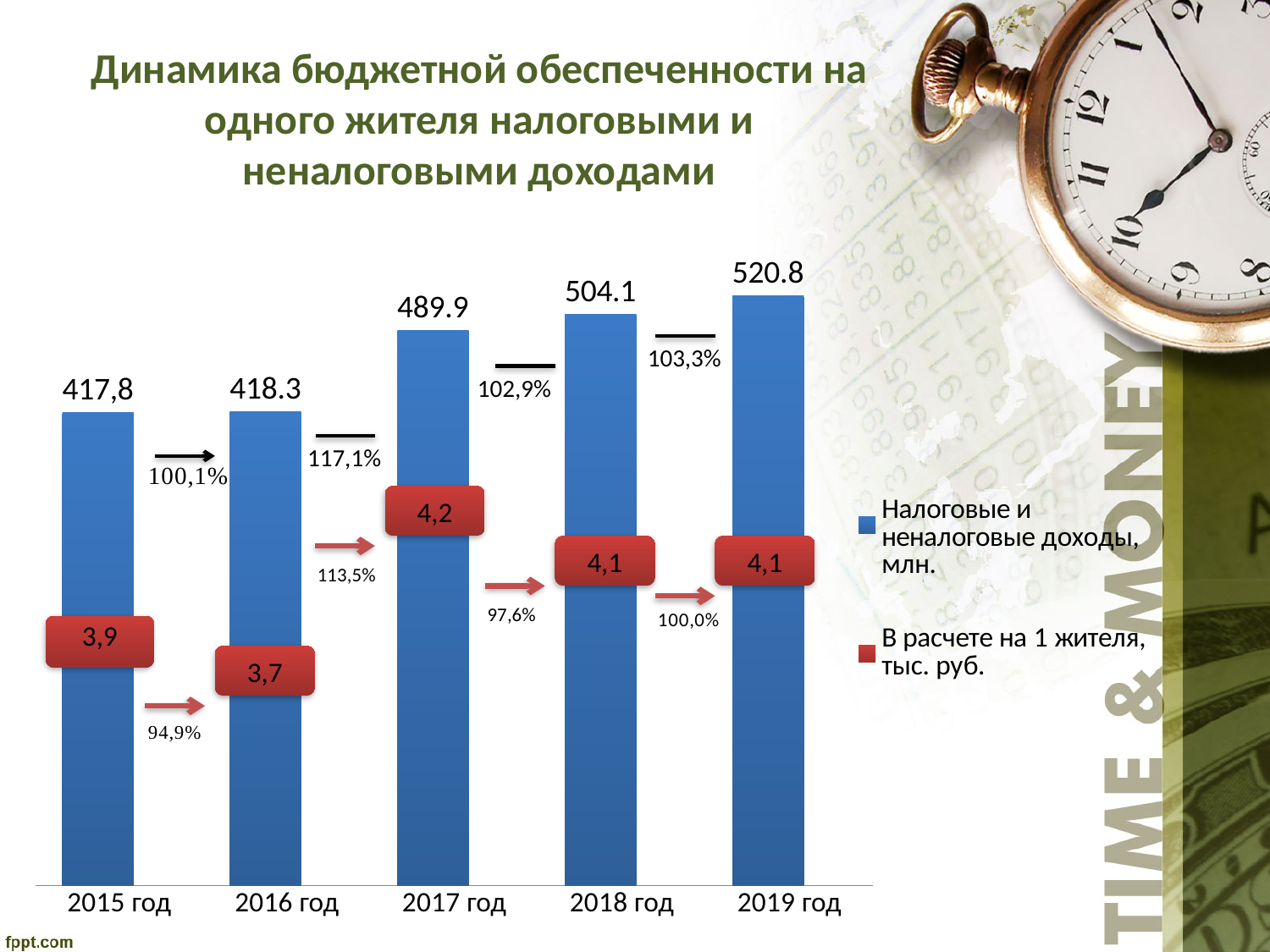
What is the difference between the tax and non-tax revenues (млн.) for 2019 год and 2018 год? 16.7 What is the per-resident value (тыс. руб.) for 2017 год? 4,2 Do the tax and non-tax revenues (млн.) rise or fall from 2015 год to 2019 год? Rise What is the value of tax and non-tax revenues (Налоговые и неналоговые доходы, млн.) for 2017 год? 489.9 What is the per-resident value (В расчете на 1 жителя, тыс. руб.) for 2016 год? 3,7 What kind of chart is shown on the slide? Bar chart How many series does the chart legend list? 2 What is the value of tax and non-tax revenues (млн.) for 2015 год? 417,8 Which is larger: the tax and non-tax revenues (млн.) for 2017 год or for 2016 год? 2017 год Which year has the highest value of tax and non-tax revenues (млн.)? 2019 год How many years are shown on the x axis of the chart? 5 Which year has the lowest per-resident value (тыс. руб.)? 2016 год